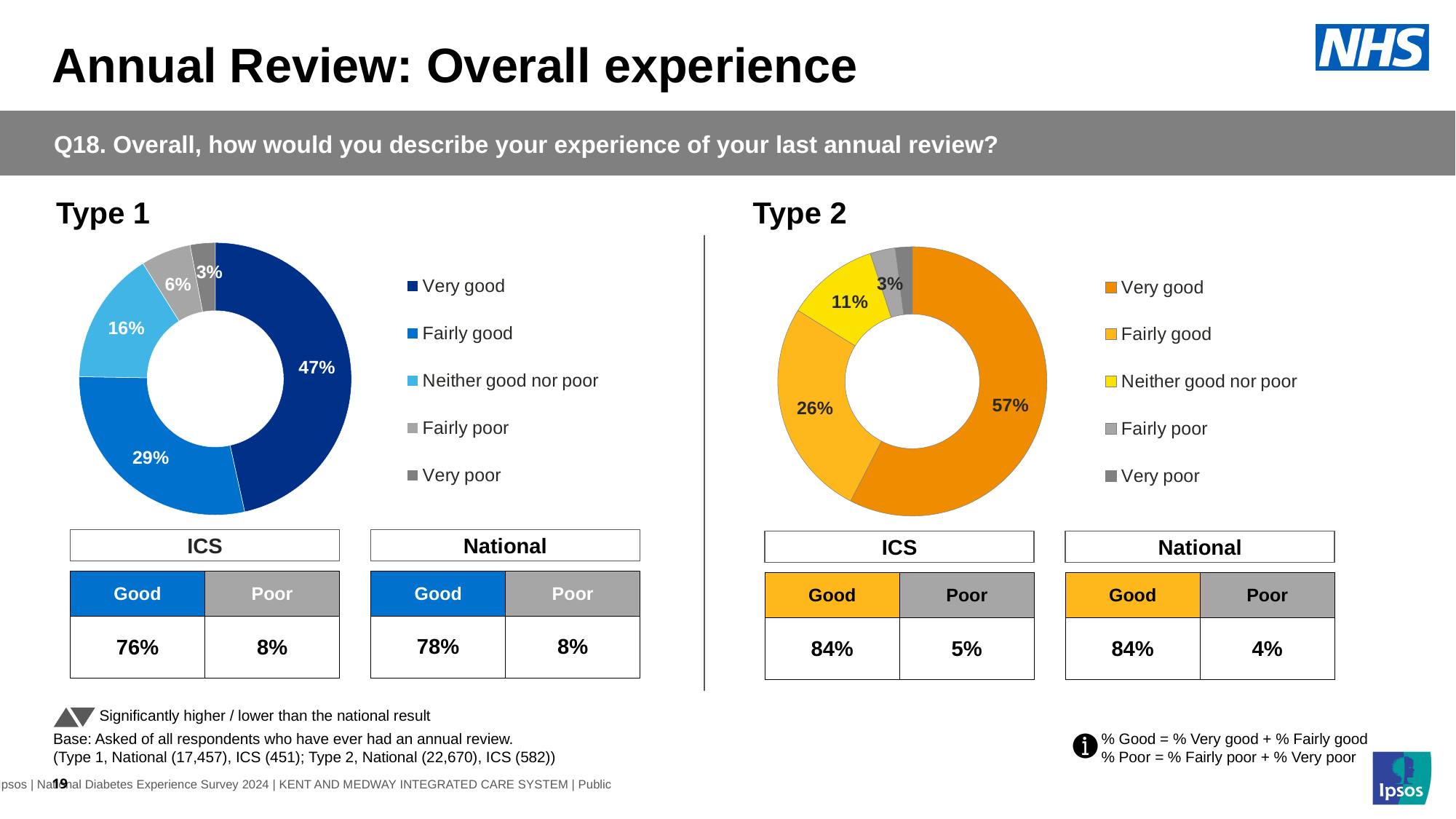
Which is larger: the Very good share in the Type 1 chart or the Very good share in the Type 2 chart? Type 2 How many categories does the legend of the Type 1 chart list? 5 In the Type 2 chart, what percentage said Neither good nor poor? 11% In the Type 1 chart, which category has the smallest share? Very poor What colour represents Very good in the Type 2 chart? Orange In the Type 2 chart, which category has the largest share? Very good In the Type 2 chart, what percentage of respondents said their experience was Fairly good? 26% What kind of chart is used for Type 1? Donut (pie) chart In the Type 1 chart, what percentage said Neither good nor poor? 16% In the Type 1 chart, what percentage of respondents said their experience was Very good? 47% In the Type 1 chart, what is the difference between the Very good and Fairly good shares? 18 percentage points In the Type 1 chart, what is the combined share of Very good and Fairly good? 76%